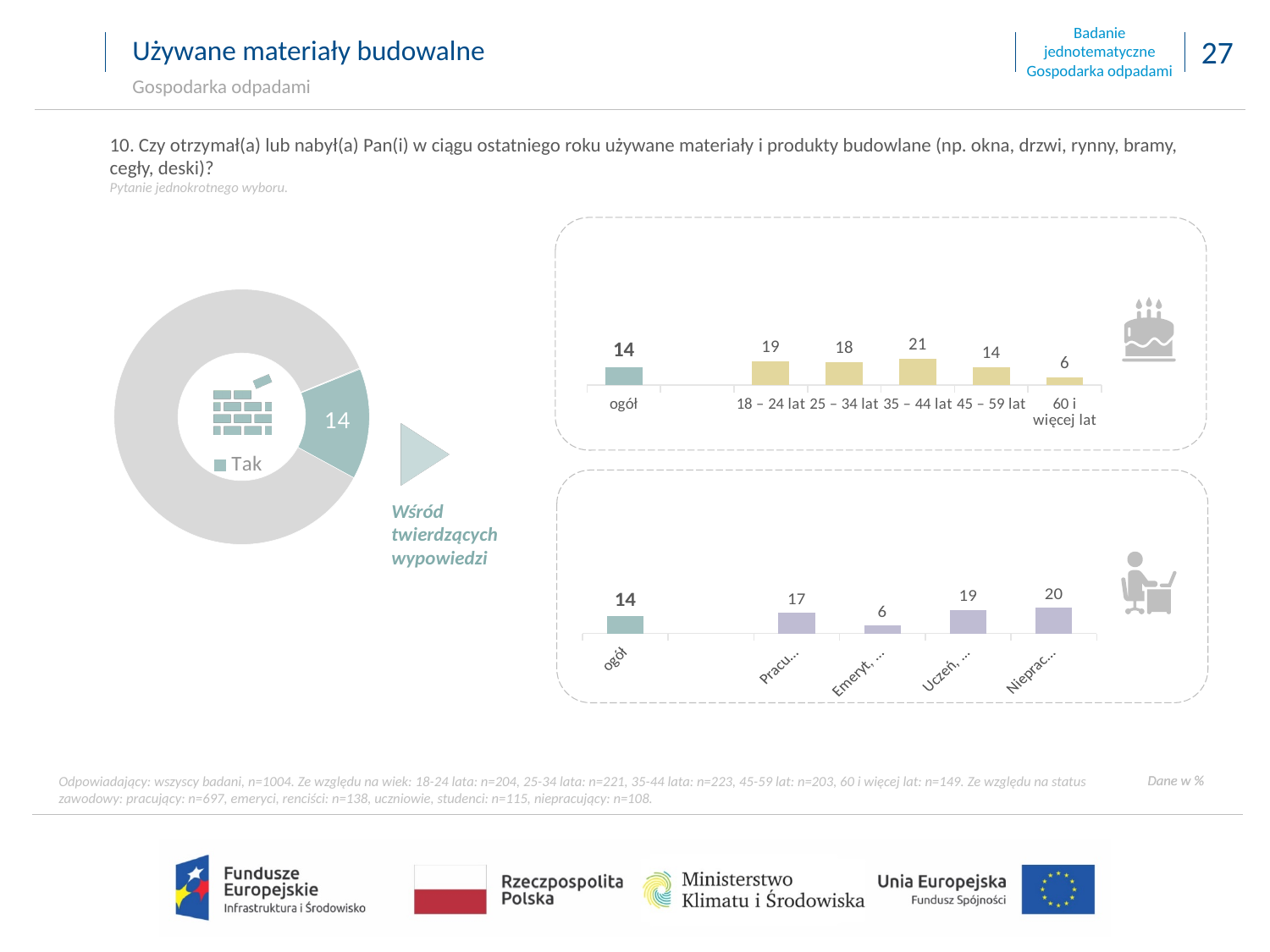
What kind of chart is the upper chart by age group? Bar chart In the upper bar chart by age group, what is the value for 60 i więcej lat? 6 In the lower bar chart by occupational status, what is the highest value shown? 20 In the donut chart on the left, what value is shown for "Tak"? 14 In the upper bar chart by age group, what is the value for 35 – 44 lat? 21 In the lower bar chart by occupational status, what is the value for ogół? 14 What kind of chart is the chart on the left showing "Tak"? Pie chart (donut) In the upper bar chart by age group, which is larger: the value for 25 – 34 lat or the value for 45 – 59 lat? 25 – 34 lat How many bars are plotted in the upper bar chart by age group? 6 In the upper bar chart by age group, which age group has the highest value? 35 – 44 lat In the upper bar chart by age group, which age group has the lowest value? 60 i więcej lat In the upper bar chart by age group, what is the difference between the values for 18 – 24 lat and 60 i więcej lat? 13